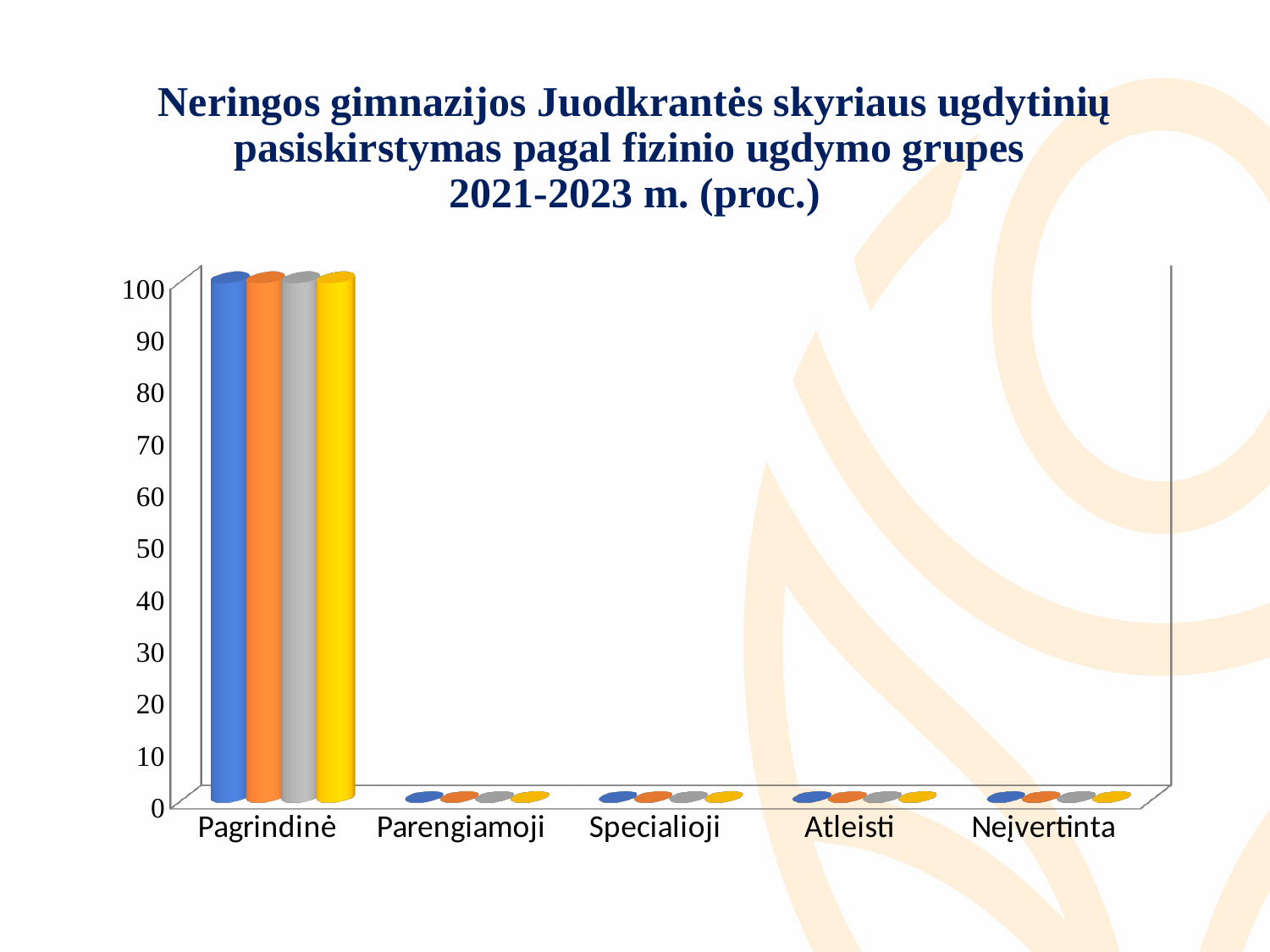
How many bars are drawn for each category in the chart? 4 Is the value for Specialioji greater or less than 10? less Which category has the highest values in the chart? Pagrindinė What value do the bars for Atleisti show? 0 How many categories are shown on the x axis of the chart? 5 Is the value for Pagrindinė greater or less than 90? greater What value do the bars for Pagrindinė reach on the axis? 100 What is the difference between the value for Pagrindinė and the value for Specialioji? 100 What kind of chart is shown on the slide? bar chart What is the title of the chart? Neringos gimnazijos Juodkrantės skyriaus ugdytinių pasiskirstymas pagal fizinio ugdymo grupes 2021-2023 m. (proc.) Which is larger, the value for Pagrindinė or the value for Neįvertinta? Pagrindinė What value do the bars for Parengiamoji show? 0